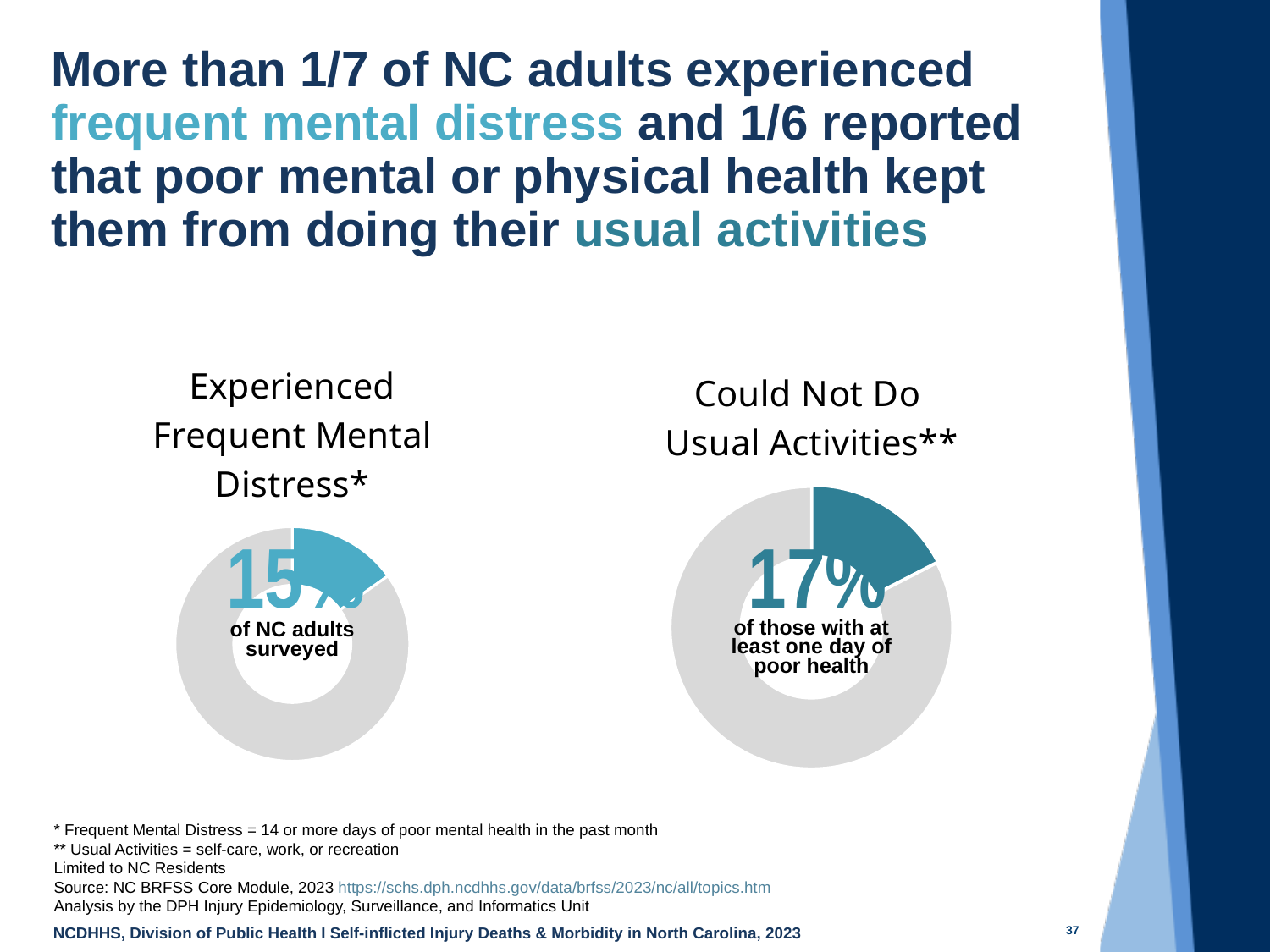
In the 'Experienced Frequent Mental Distress*' chart, what percentage is shown? 15% In the 'Could Not Do Usual Activities**' chart, what group does the 17% refer to, according to the label inside the donut? of those with at least one day of poor health In the 'Could Not Do Usual Activities**' chart, what share of the donut does the highlighted (teal) slice represent? 17% What is the title of the chart on the right side of the slide? Could Not Do Usual Activities** In the 'Experienced Frequent Mental Distress*' chart, what group does the percentage refer to, according to the label inside the donut? of NC adults surveyed What is the title of the chart on the left side of the slide? Experienced Frequent Mental Distress* Which chart shows the larger percentage, 'Experienced Frequent Mental Distress*' or 'Could Not Do Usual Activities**'? Could Not Do Usual Activities** What kind of chart is used for 'Experienced Frequent Mental Distress*'? Donut (pie) chart What is the difference between the percentage in the 'Could Not Do Usual Activities**' chart and the percentage in the 'Experienced Frequent Mental Distress*' chart? 2 percentage points In the 'Could Not Do Usual Activities**' chart, what percentage is shown? 17% How many donut charts are shown on the slide? 2